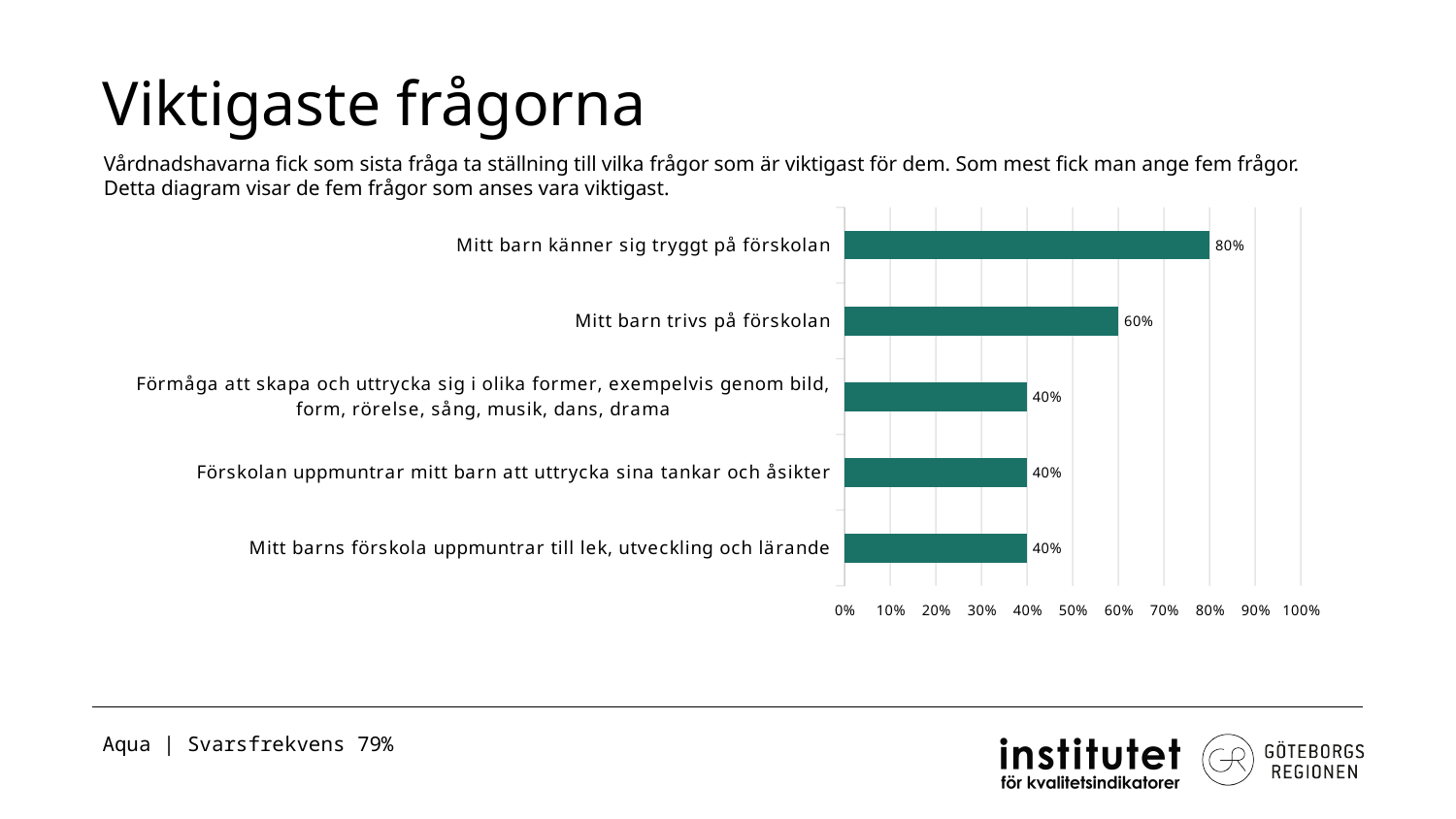
What kind of chart is shown on the slide? Bar chart What is the value for "Mitt barns förskola uppmuntrar till lek, utveckling och lärande"? 40% Which is larger: the value for "Mitt barn trivs på förskolan" or the value for "Förskolan uppmuntrar mitt barn att uttrycka sina tankar och åsikter"? Mitt barn trivs på förskolan How many categories are shown in the chart? 5 Which category has the highest value? Mitt barn känner sig tryggt på förskolan What is the value for "Mitt barn känner sig tryggt på förskolan"? 80% What is the difference between the values for "Mitt barn känner sig tryggt på förskolan" and "Mitt barn trivs på förskolan"? 20% What is the value for "Förskolan uppmuntrar mitt barn att uttrycka sina tankar och åsikter"? 40% Is the value for "Mitt barn känner sig tryggt på förskolan" greater or less than 70%? greater What is the title of the slide containing the chart? Viktigaste frågorna What is the value for "Mitt barn trivs på förskolan"? 60% What is the difference between the values for "Mitt barn trivs på förskolan" and "Mitt barns förskola uppmuntrar till lek, utveckling och lärande"? 20%